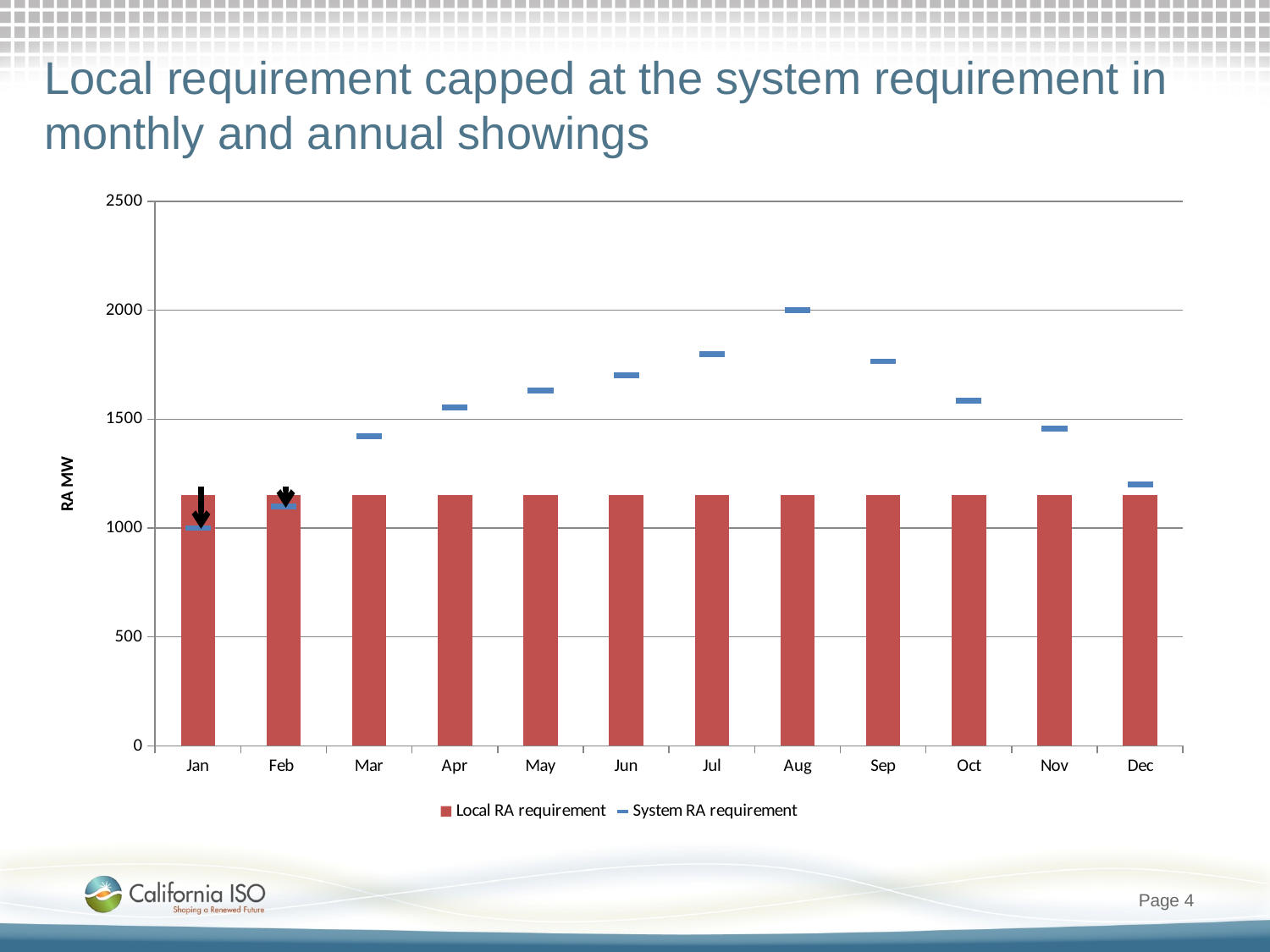
What kind of chart is shown on the slide? bar chart In which month is the System RA requirement highest? Aug How many series does the chart's legend list? 2 Is the Local RA requirement for Mar greater or less than 1000? greater Is the Local RA requirement for Jun greater or less than 1500? less What is the label on the chart's y axis? RA MW Does the System RA requirement rise or fall from Jan to Aug? rise Is the System RA requirement for Dec greater or less than 1500? less Which is larger, the System RA requirement for Jul or for Mar? Jul In which month is the System RA requirement lowest? Jan How many months are shown along the x axis of the chart? 12